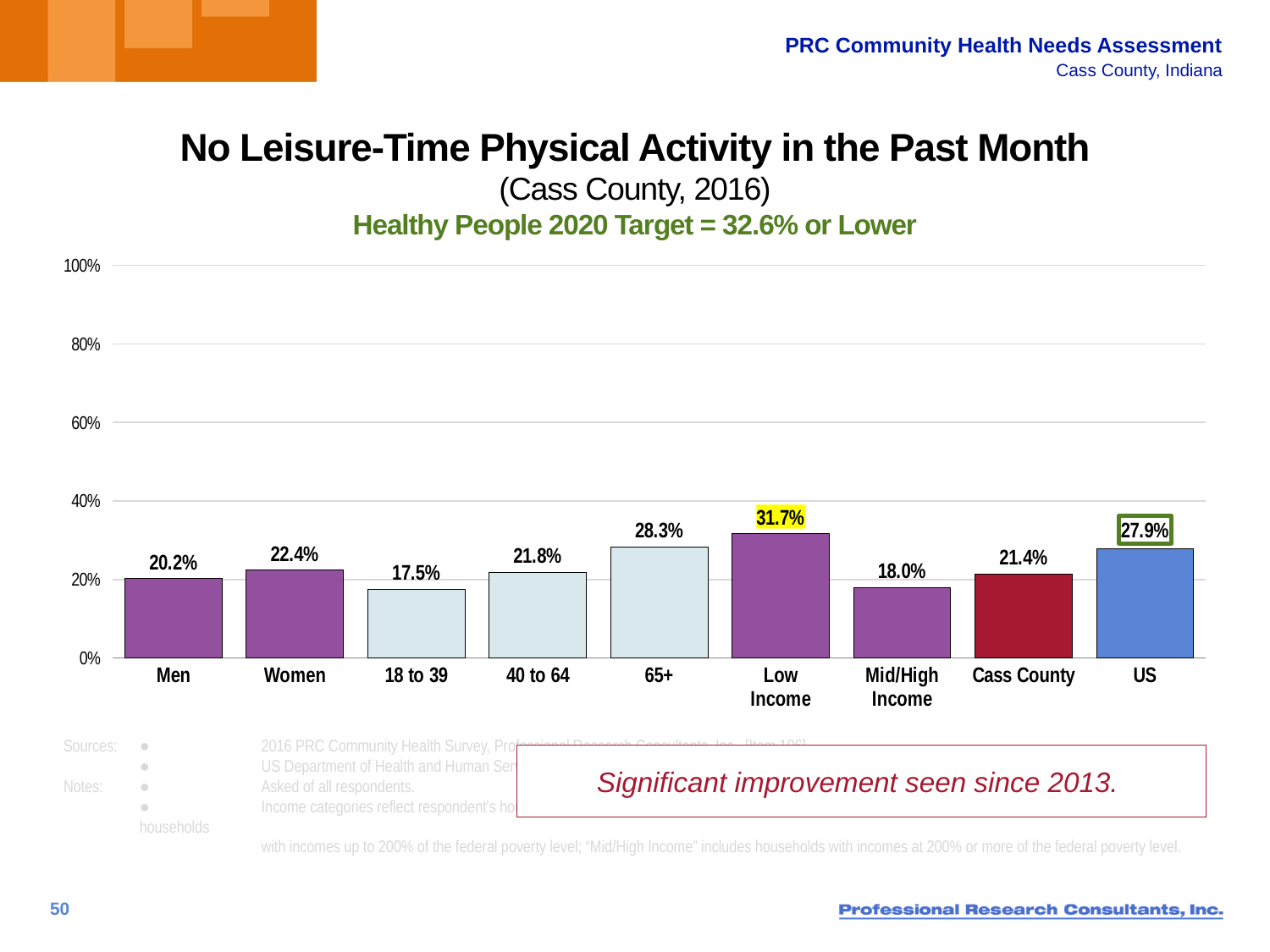
What is the difference between the Low Income and Mid/High Income values? 13.7% What is the Healthy People 2020 Target stated on the slide? 32.6% or Lower What is the value for Women? 22.4% Is the value for Low Income greater or less than 40%? less Which category has the lowest value? 18 to 39 What is the value for the 65+ age group? 28.3% Which category has the highest value? Low Income What kind of chart is this? bar chart Which is larger, the value for Men or the value for Women? Women What is the value for Cass County? 21.4% What is the difference between the US value and the Cass County value? 6.5% How many categories are shown on the x axis? 9